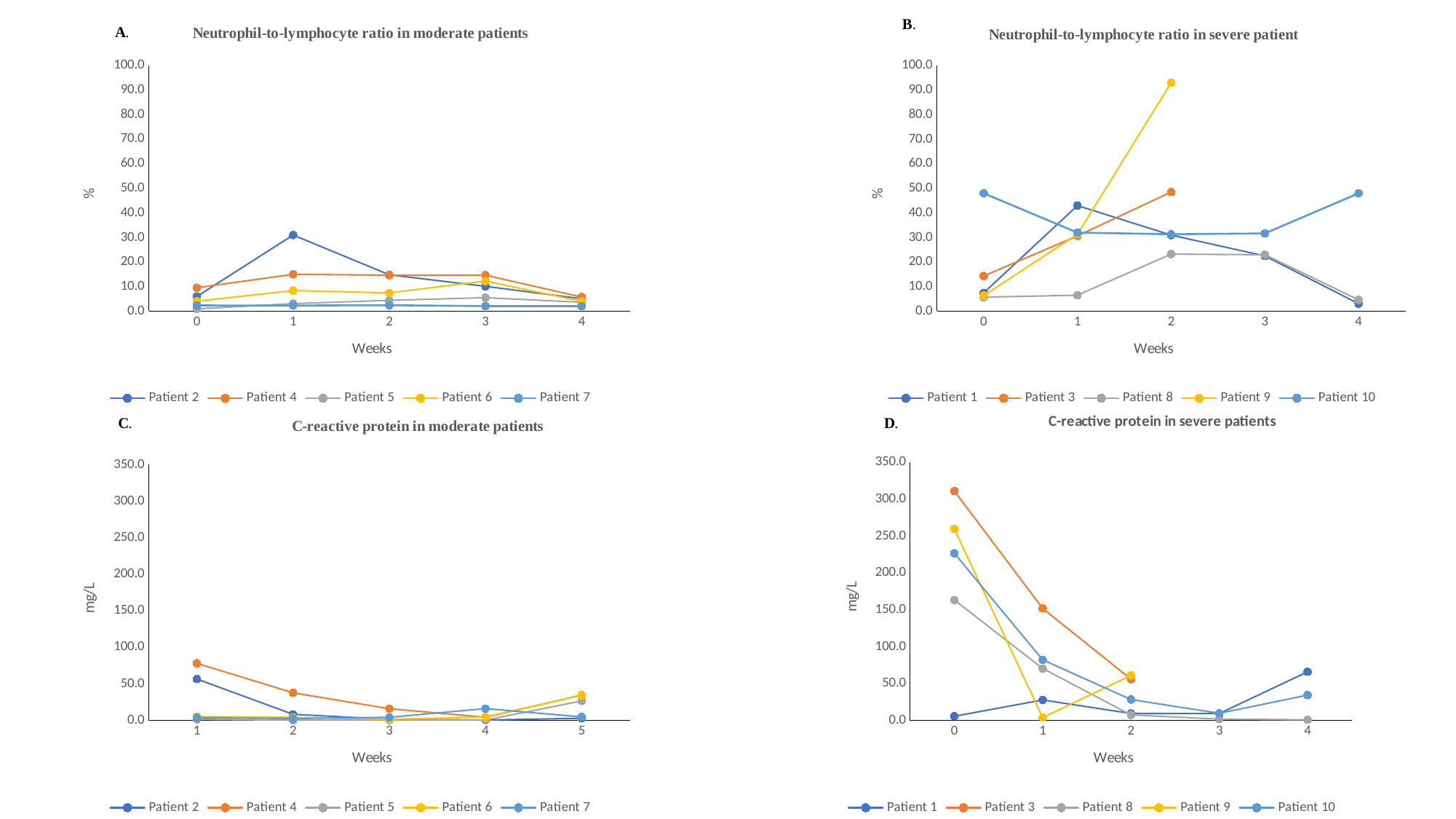
In chart A, "Neutrophil-to-lymphocyte ratio in moderate patients", is the value for Patient 2 at week 1 greater or less than 20.0? greater What kind of chart is chart A, "Neutrophil-to-lymphocyte ratio in moderate patients"? Line chart In chart C, "C-reactive protein in moderate patients", which patient has the highest value at week 1? Patient 4 In chart B, "Neutrophil-to-lymphocyte ratio in severe patient", which patient reaches the highest value on the chart? Patient 9 In chart D, "C-reactive protein in severe patients", is the value for Patient 3 at week 0 greater or less than 300.0? greater In chart D, "C-reactive protein in severe patients", which patient has the highest value at week 0? Patient 3 How many series does the legend of chart B, "Neutrophil-to-lymphocyte ratio in severe patient", list? 5 How many points along the Weeks axis does chart C, "C-reactive protein in moderate patients", show? 5 What is the y-axis unit label on chart D, "C-reactive protein in severe patients"? mg/L In chart B, "Neutrophil-to-lymphocyte ratio in severe patient", is the value for Patient 9 at week 2 greater or less than 80.0? greater In chart D, "C-reactive protein in severe patients", does the value for Patient 3 rise or fall from week 0 to week 2? fall